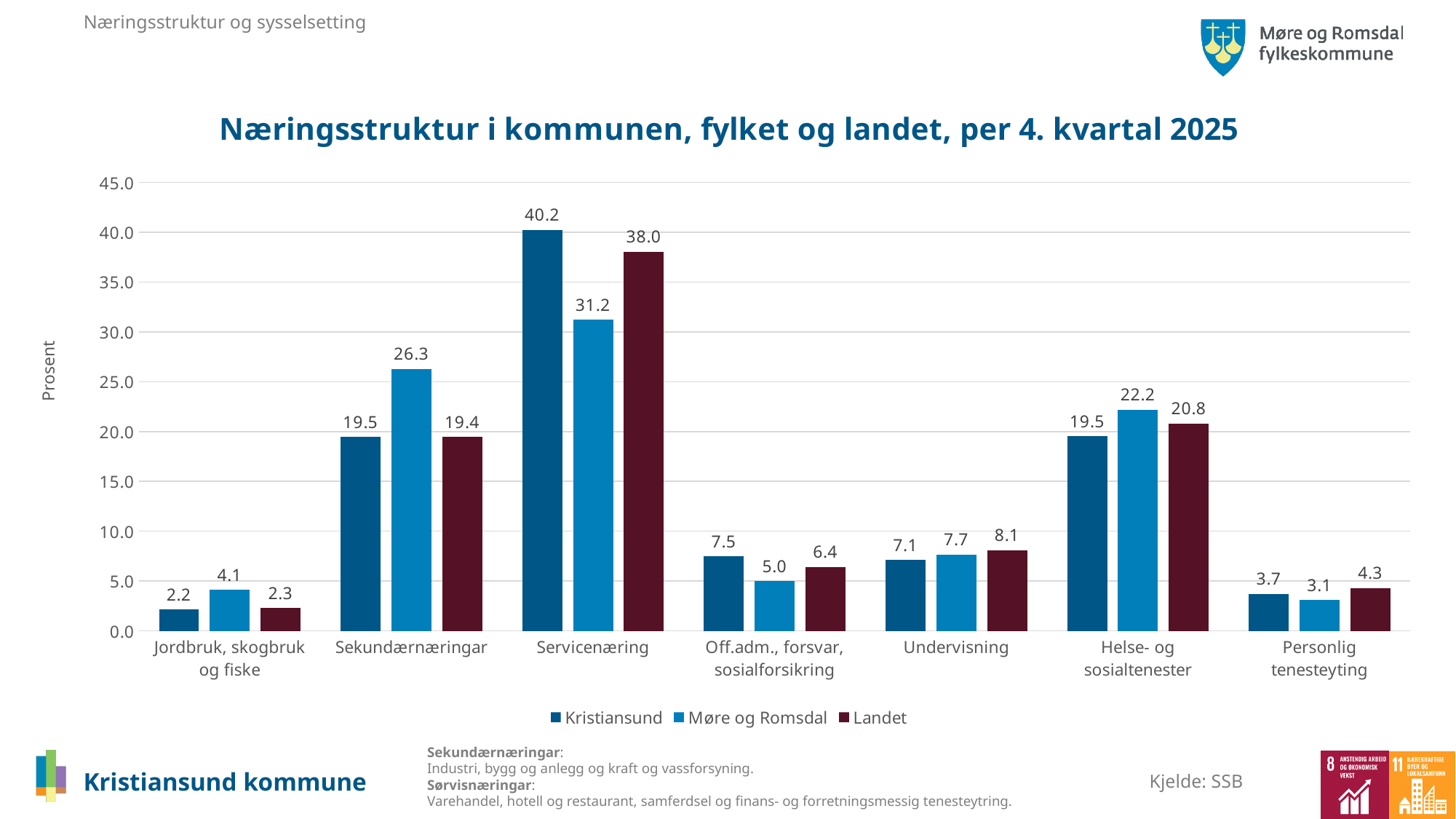
What is the value for Landet in Helse- og sosialtenester? 20.8 What is the label of the y axis? Prosent Which is larger in Off.adm., forsvar, sosialforsikring: Kristiansund or Landet? Kristiansund Which category has the lowest value for Møre og Romsdal? Personlig tenesteyting What is the value for Møre og Romsdal in Sekundærnæringar? 26.3 Which category has the highest value for Kristiansund? Servicenæring What is the value for Kristiansund in Servicenæring? 40.2 Is the value for Møre og Romsdal in Helse- og sosialtenester greater or less than 20.0? greater What is the difference between the Landet and Møre og Romsdal values in Servicenæring? 6.8 How many categories are shown on the x axis? 7 What kind of chart is shown on the slide? Bar chart How many series does the legend list? 3